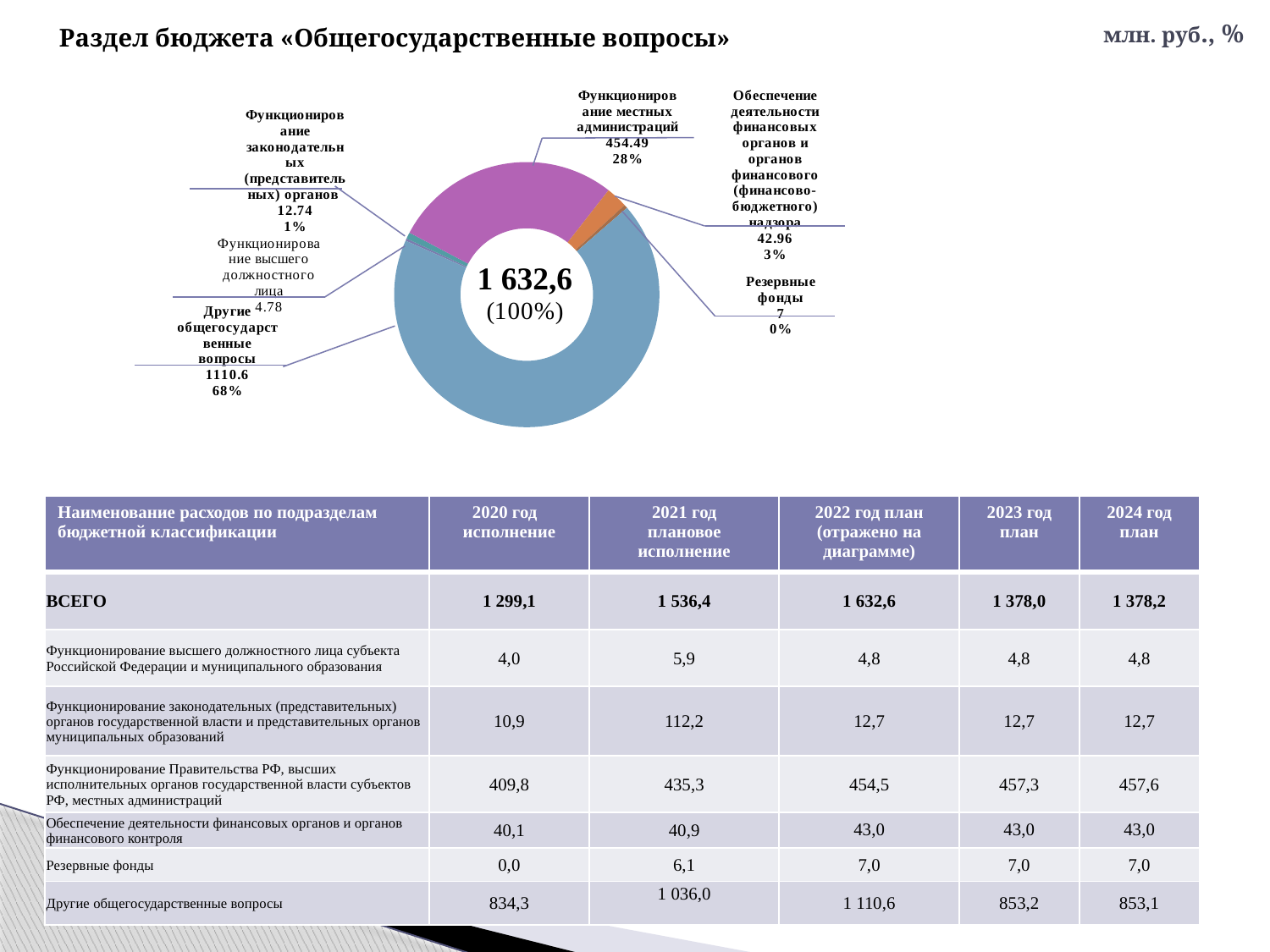
What total value is shown in the centre of the doughnut chart? 1 632,6 What share of the chart does «Функционирование местных администраций» represent? 28% What value is shown for «Резервные фонды» on the chart? 7 What value is shown for «Функционирование законодательных (представительных) органов» on the chart? 12.74 What share of the chart does «Другие общегосударственные вопросы» represent? 68% What value is shown for «Функционирование местных администраций» on the chart? 454.49 What value is shown for «Обеспечение деятельности финансовых органов и органов финансового (финансово-бюджетного) надзора» on the chart? 42.96 Which is larger on the chart: «Функционирование местных администраций» or «Обеспечение деятельности финансовых органов»? Функционирование местных администраций What kind of chart is shown on the slide? Doughnut (pie) chart What value is shown for «Другие общегосударственные вопросы» on the chart? 1110.6 What is the difference between the values for «Другие общегосударственные вопросы» and «Функционирование местных администраций» on the chart? 656.11 Which category has the largest slice of the chart? Другие общегосударственные вопросы